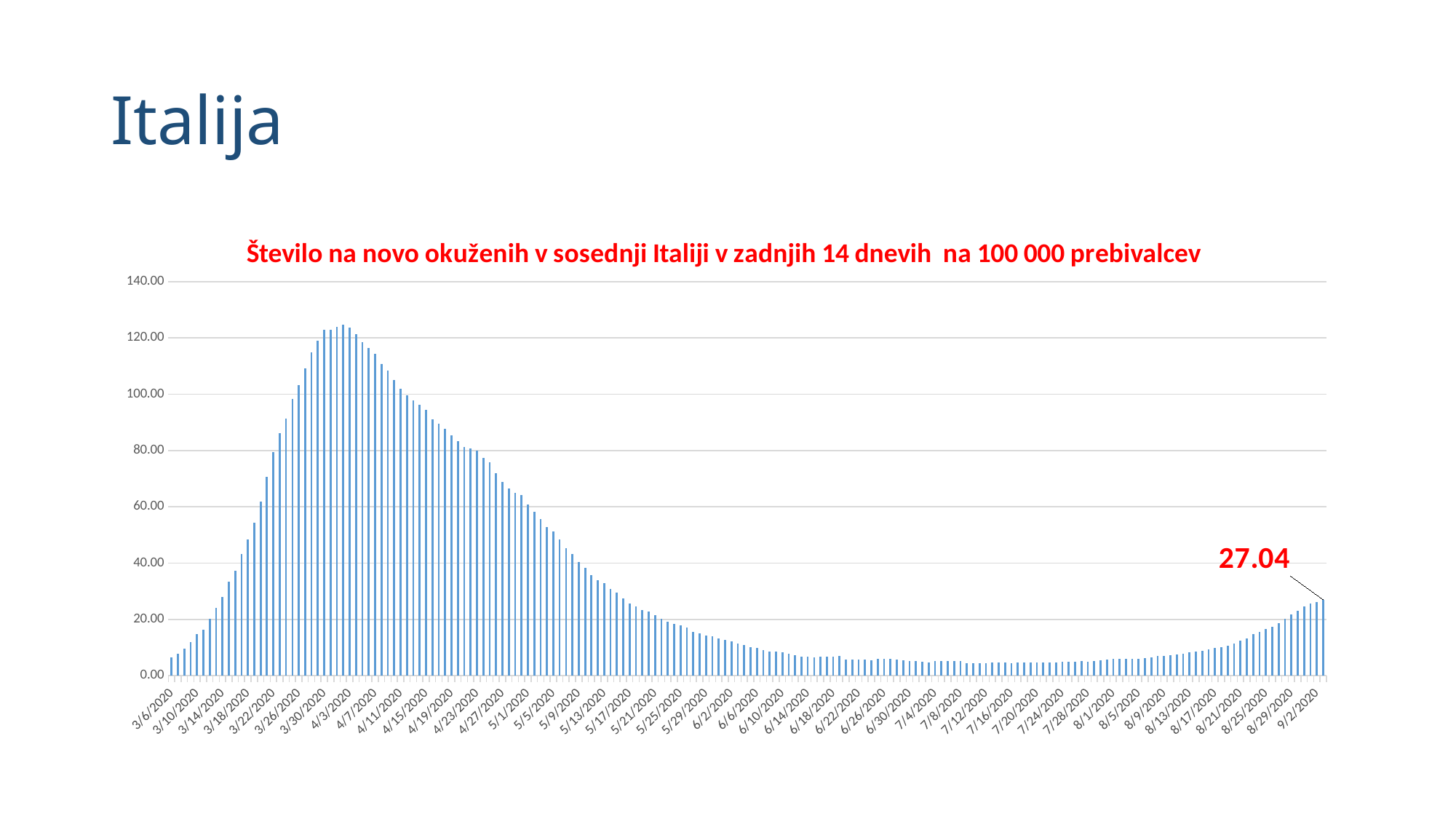
What is the title of the chart? Število na novo okuženih v sosednji Italiji v zadnjih 14 dnevih na 100 000 prebivalcev Is the value for 3/30/2020 greater or less than 100? greater Which is larger, the value for 3/22/2020 or the value for 8/29/2020? 3/22/2020 Do the values rise or fall between 8/1/2020 and 9/2/2020? rise Is the value for 7/4/2020 greater or less than 20? less Do the values rise or fall between 4/7/2020 and 6/14/2020? fall Is the value for 5/13/2020 greater or less than 60? less What kind of chart is shown on the slide? bar chart What value is printed on the data label at the right end of the chart? 27.04